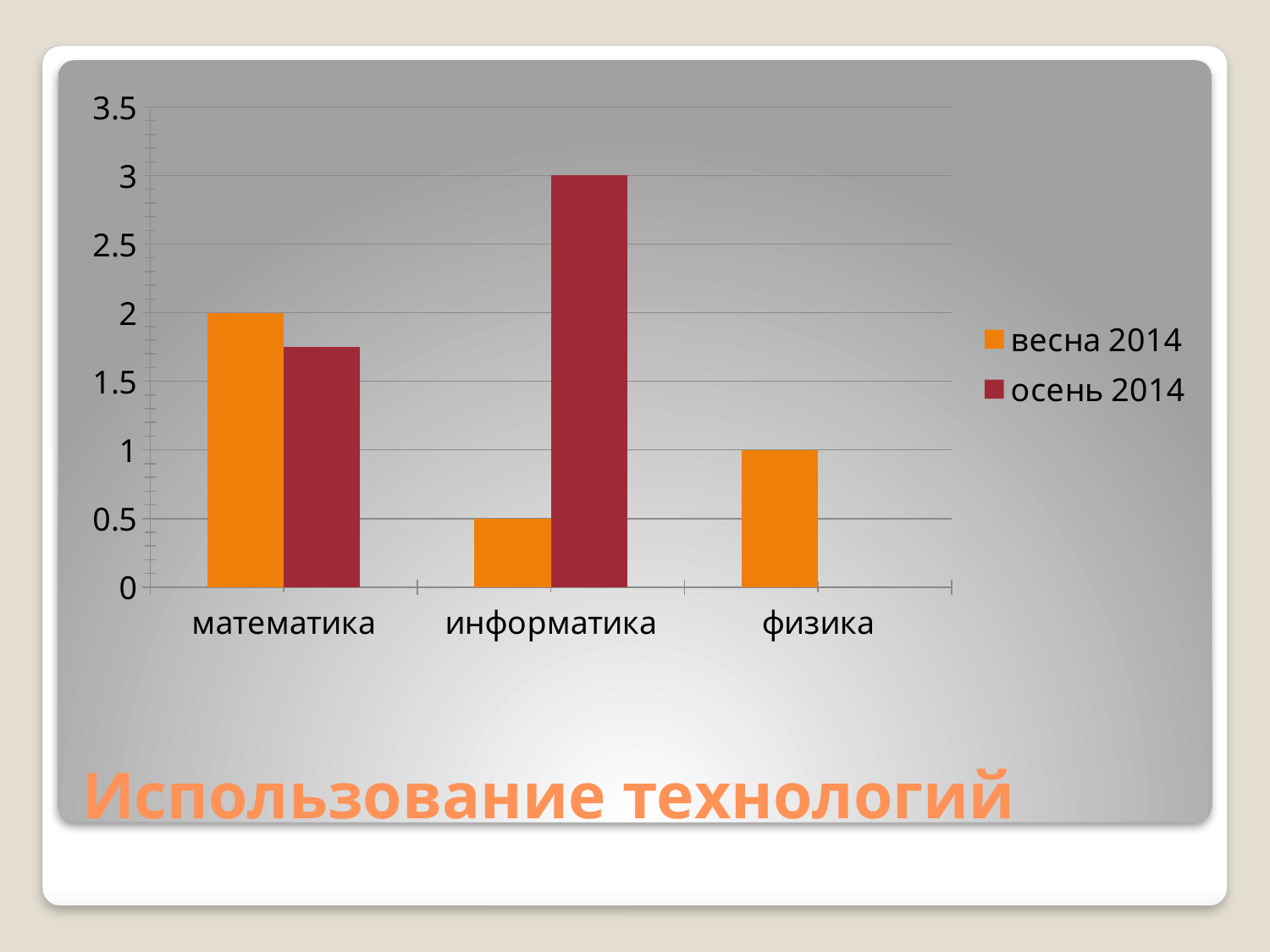
Is the value for математика in the осень 2014 series greater or less than 1.5? greater Which category has the highest value in the весна 2014 series? математика What is the value for физика in the весна 2014 series? 1 How many categories are shown on the x axis? 3 What is the value for информатика in the весна 2014 series? 0.5 What is the value for математика in the весна 2014 series? 2 What is the value for информатика in the осень 2014 series? 3 What kind of chart is shown on the slide? bar chart Which category has the highest value in the осень 2014 series? информатика What is the difference between the осень 2014 and весна 2014 values for информатика? 2.5 How many series does the legend list? 2 For информатика, which series has the larger value, весна 2014 or осень 2014? осень 2014